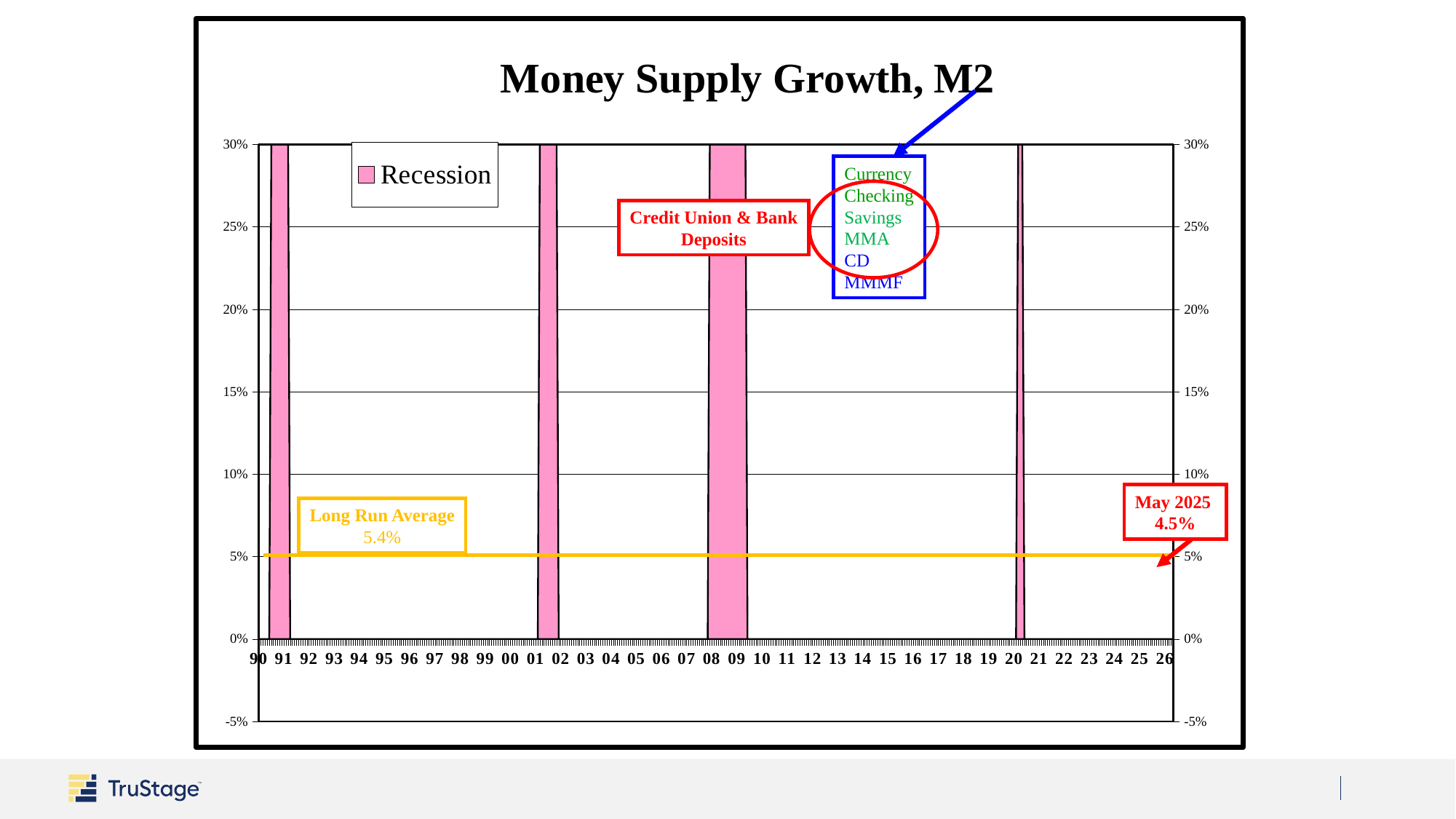
What is the M2 money supply growth value shown for May 2025? 4.5% What is the difference between the Long Run Average (5.4%) and the May 2025 value (4.5%)? 0.9 percentage points What is the last year label on the horizontal axis? 26 Which is larger, the Long Run Average or the May 2025 value? Long Run Average What is the Long Run Average value shown on the chart? 5.4% How many recession periods are shaded on the chart? 4 How many entries does the chart legend list? 1 Is the Long Run Average greater or less than 5%? greater What is the first year label on the horizontal axis? 90 Is the May 2025 value greater or less than 5%? less What is the title of the chart? Money Supply Growth, M2 What is the highest value shown on the vertical axis? 30%